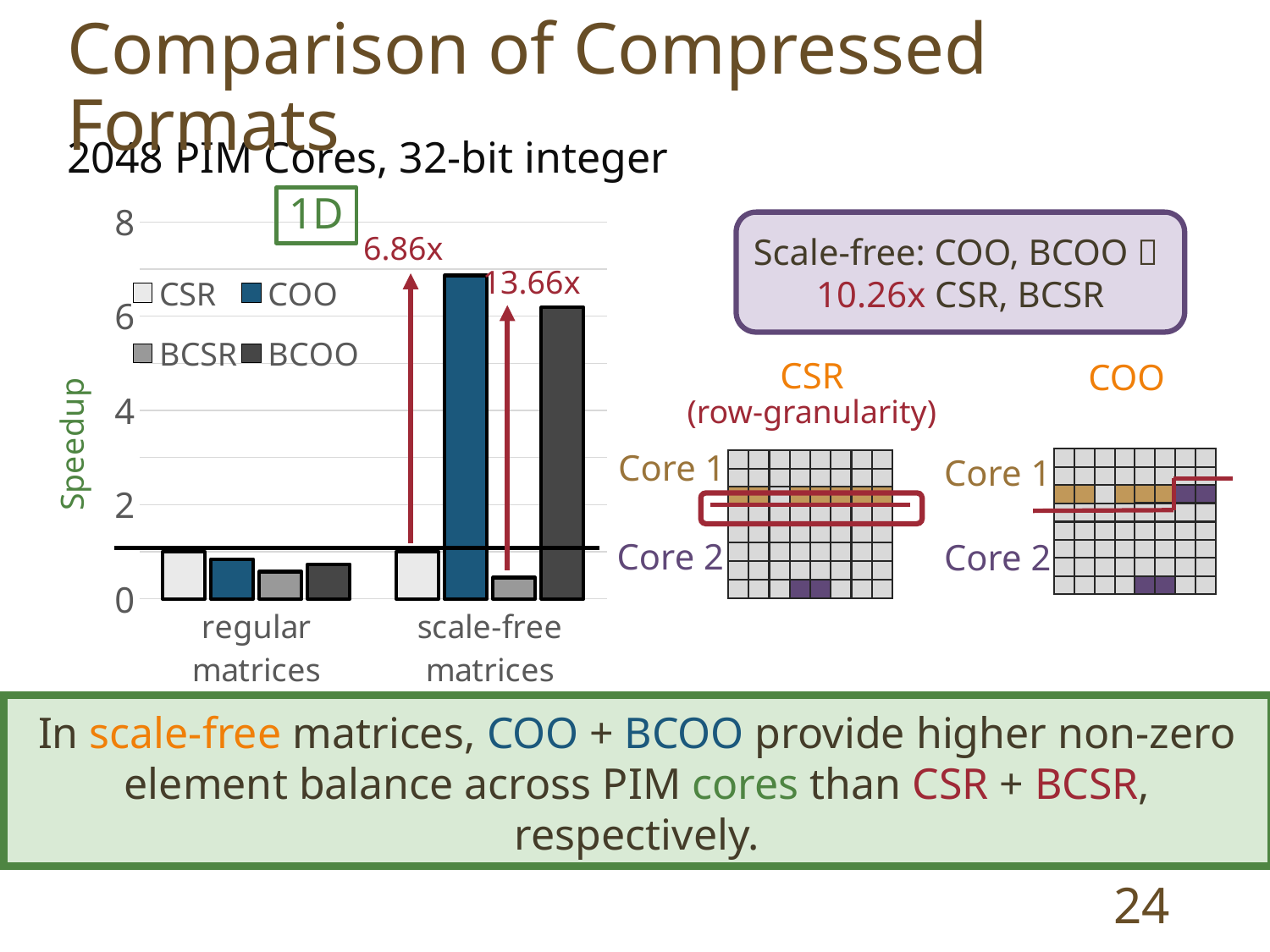
Which series has the highest speedup for scale-free matrices? COO How many series does the chart legend list? 4 What is the label of the y axis of the chart? Speedup For scale-free matrices, which has the larger speedup, COO or BCOO? COO Which series has the lowest speedup for scale-free matrices? BCSR How many categories are shown on the x axis of the chart? 2 What kind of chart is shown on the slide? bar chart Is the speedup for BCSR on scale-free matrices greater or less than 2? less Is the speedup for COO on scale-free matrices greater or less than 6? greater Is the speedup for BCOO on scale-free matrices greater or less than 4? greater What annotation is printed above the COO bar for scale-free matrices? 6.86x